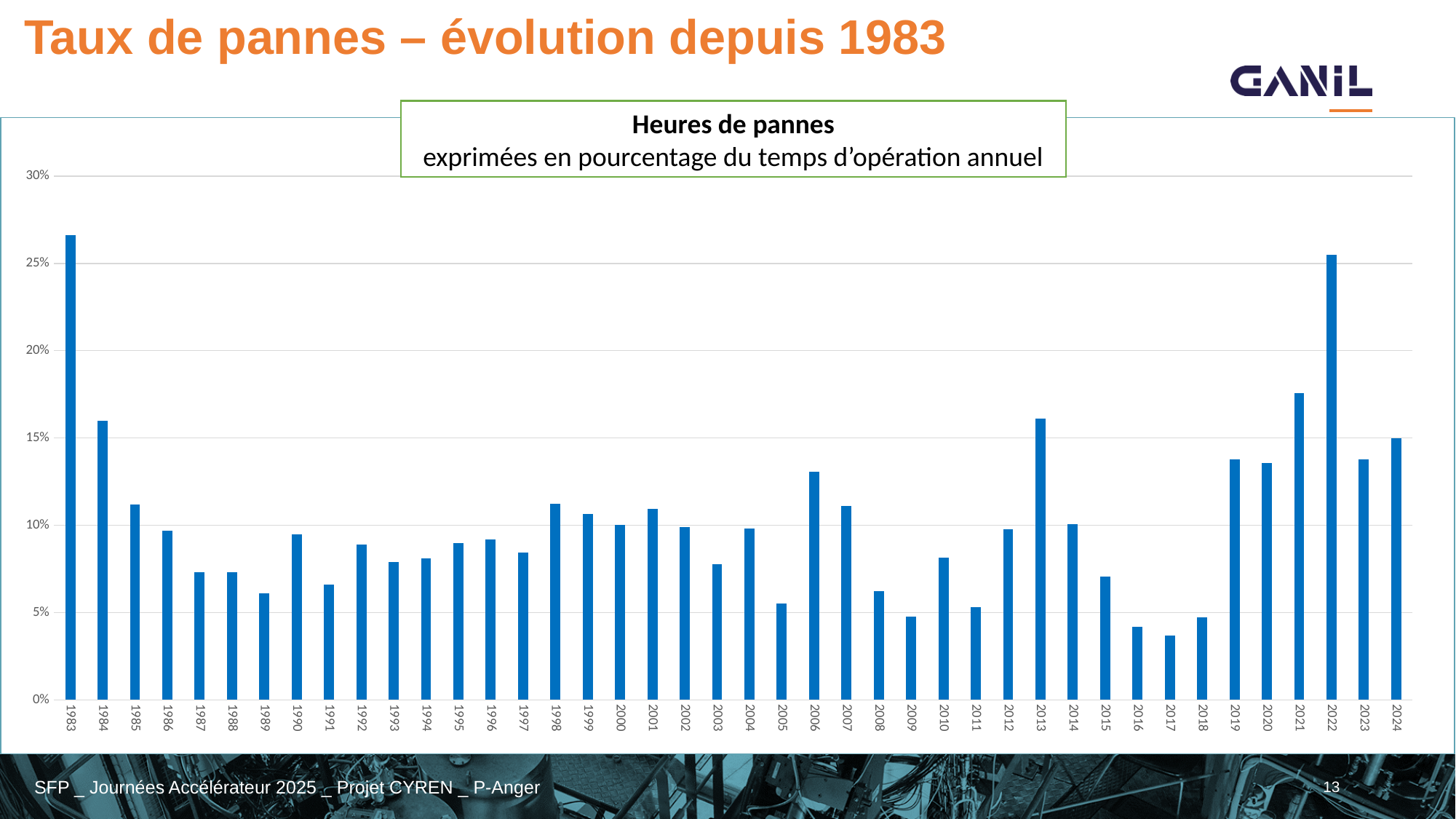
What kind of chart is shown on the slide? bar chart Which year has the larger value, 1984 or 2020? 1984 Which year has the lowest failure rate on the chart? 2017 Is the value for 1983 greater or less than 25%? greater Which year has the highest failure rate on the chart? 1983 Is the value for 2006 greater or less than 10%? greater Which year has the larger value, 2013 or 2021? 2021 Do the values rise or fall from 2017 to 2022? rise What is the title shown in the box above the chart? Heures de pannes Is the value for 2017 greater or less than 5%? less How many years (bars) are plotted on the chart? 42